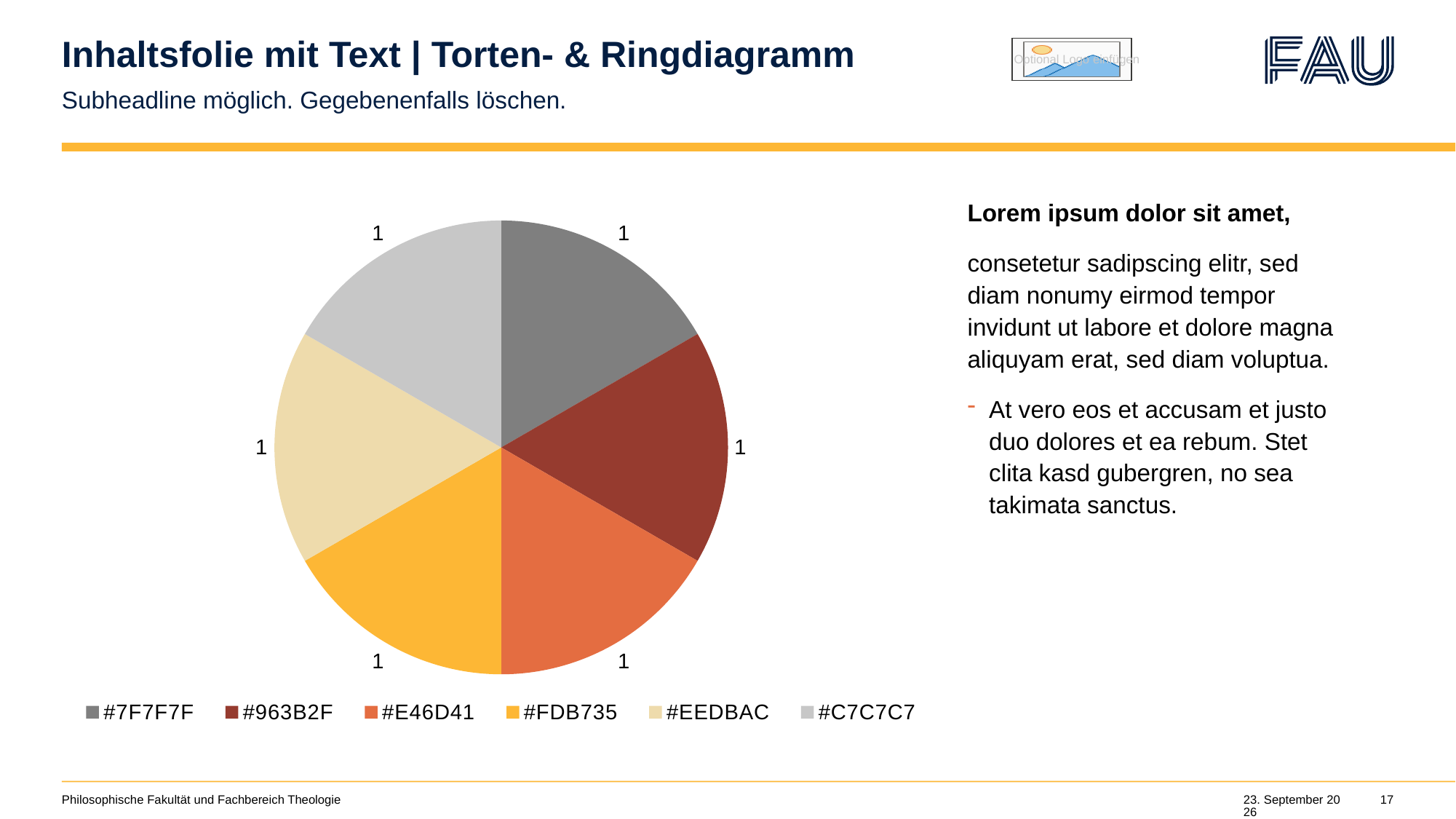
How many entries does the legend of the pie chart list? 6 Which legend entry is shown first in the pie chart's legend? #7F7F7F What is the value of the #FDB735 slice in the pie chart? 1 What is the total of all slice values in the pie chart? 6 Which legend entry corresponds to the dark red slice of the pie chart? #963B2F What fraction of the pie does the #EEDBAC slice represent? 1/6 What is the value of the #7F7F7F slice in the pie chart? 1 How many slices does the pie chart have? 6 What is the value of the #C7C7C7 slice in the pie chart? 1 What kind of chart is shown on the slide? pie chart What is the difference between the values of the #963B2F slice and the #E46D41 slice? 0